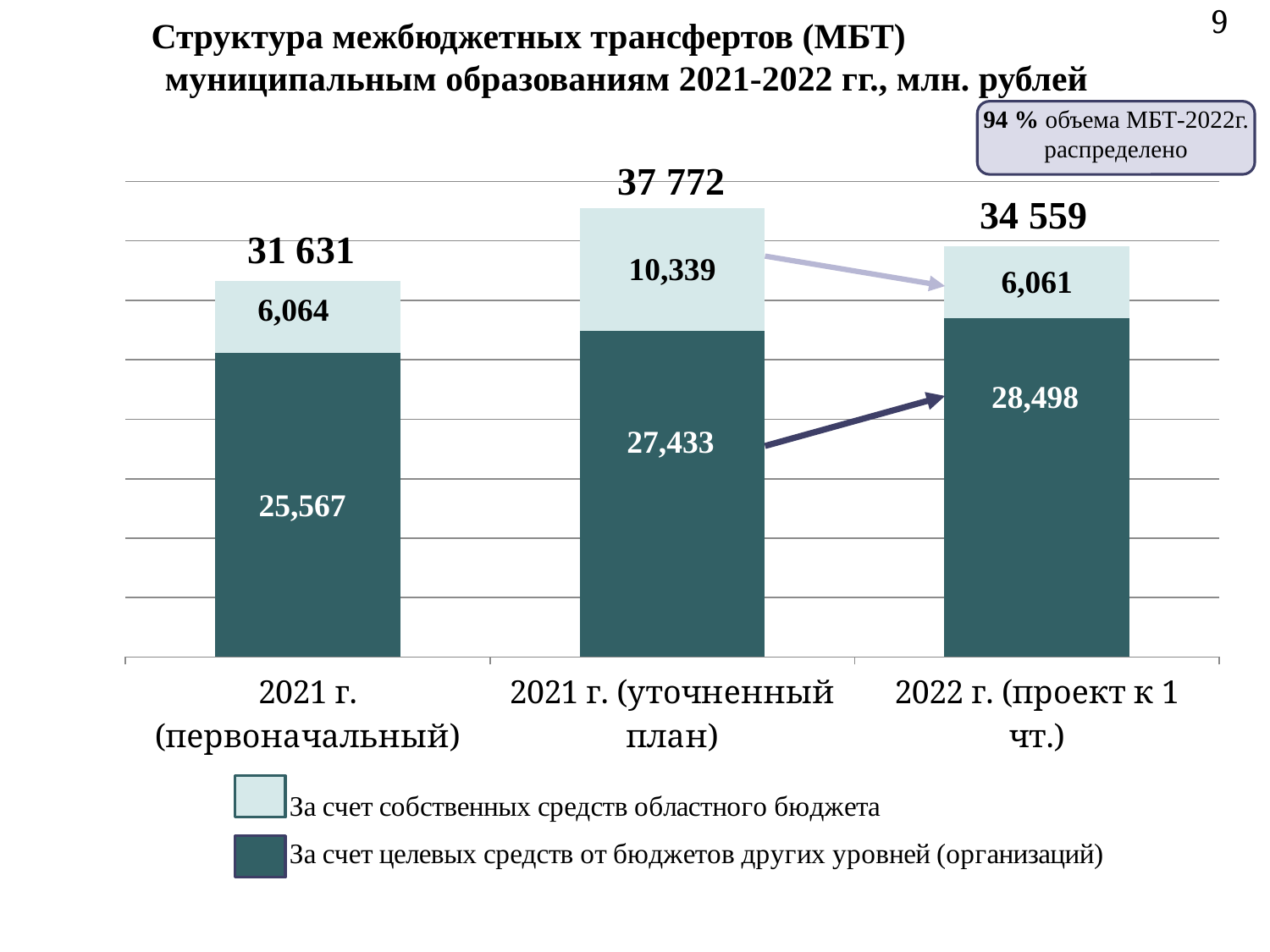
What kind of chart is shown on the slide? stacked bar chart What is the total shown above the bar for '2021 г. (уточненный план)'? 37 772 What percentage of the 2022 MBT volume is stated as distributed in the box at the top right? 94 % Which category has the highest total? 2021 г. (уточненный план) What is the total shown above the bar for '2022 г. (проект к 1 чт.)'? 34 559 How many series does the legend list? 2 What is the value of 'За счет собственных средств областного бюджета' for '2021 г. (уточненный план)'? 10,339 How many categories (bars) are shown on the x axis? 3 Which is larger: the 'За счет собственных средств областного бюджета' value for '2021 г. (уточненный план)' or for '2022 г. (проект к 1 чт.)'? 2021 г. (уточненный план) What is the value of 'За счет целевых средств от бюджетов других уровней (организаций)' for '2022 г. (проект к 1 чт.)'? 28,498 What is the value of 'За счет целевых средств от бюджетов других уровней (организаций)' for '2021 г. (первоначальный)'? 25,567 Which category has the lowest total? 2021 г. (первоначальный)